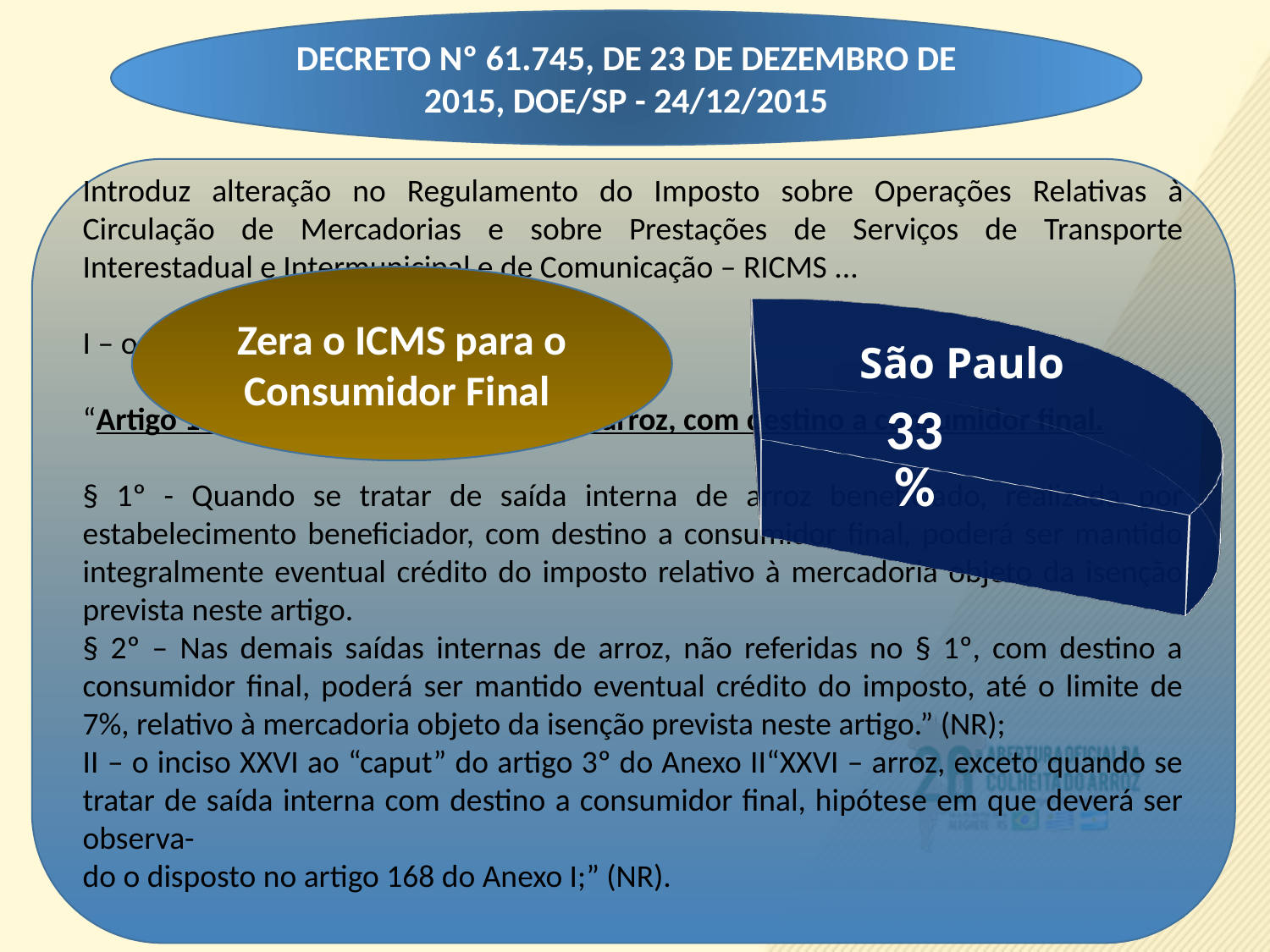
What share of the pie does the São Paulo slice represent? 33% What kind of chart is shown on the right side of the slide? pie chart Which category is labeled on the visible slice of the pie chart? São Paulo What value is shown for the São Paulo slice of the pie chart? 33%